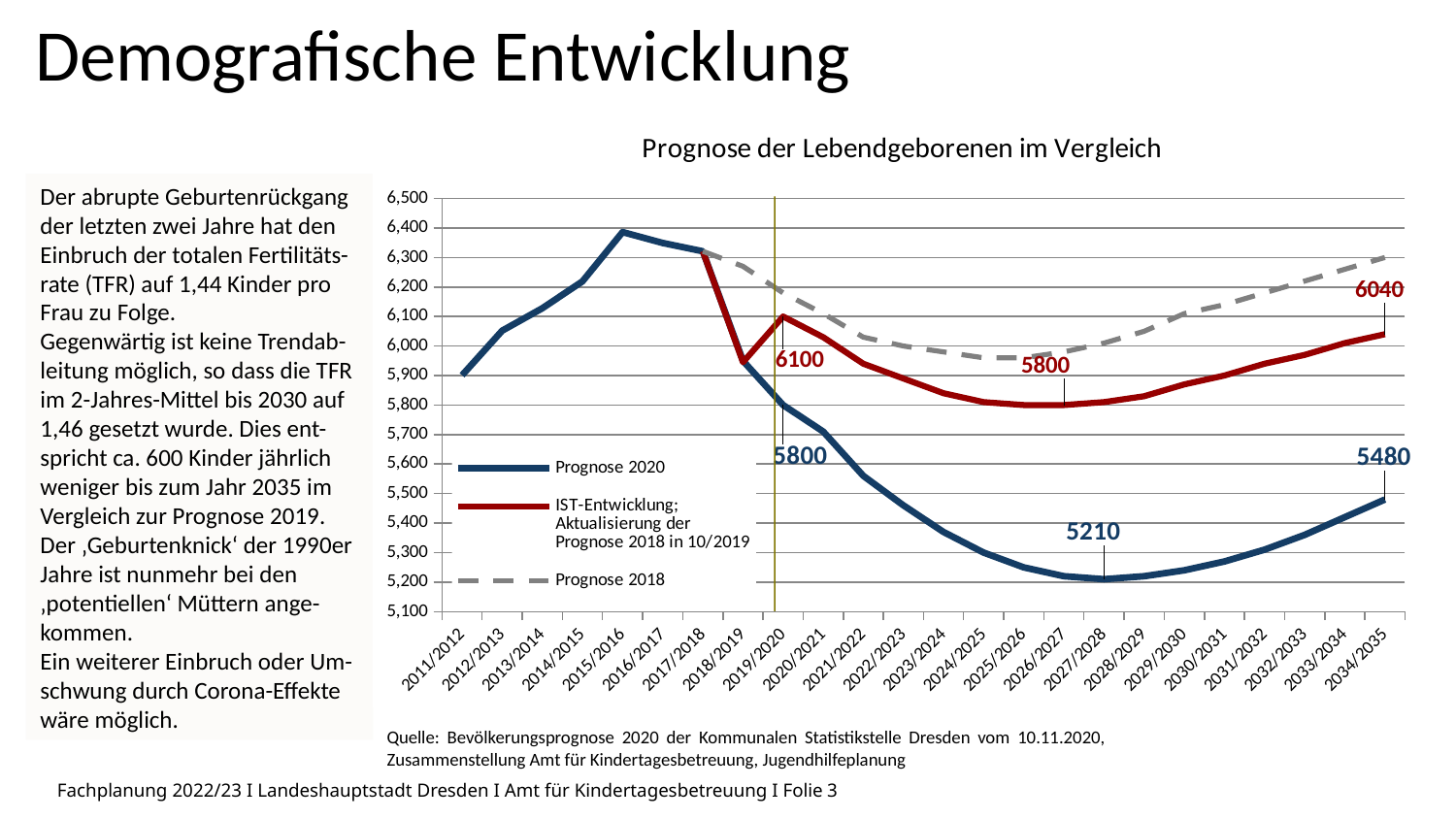
What is the difference between the IST-Entwicklung value and the Prognose 2020 value for 2034/2035? 560 Which series has the higher value for 2034/2035, Prognose 2020 or IST-Entwicklung? IST-Entwicklung What is the value of Prognose 2020 for 2027/2028? 5210 How many year categories are shown on the x axis? 24 What kind of chart is shown on the slide? line chart What is the value of the IST-Entwicklung series for 2019/2020? 6100 What is the value of the IST-Entwicklung series for 2034/2035? 6040 Is the value of Prognose 2018 for 2034/2035 greater or less than 6,200? greater How many series does the chart legend list? 3 What is the value of Prognose 2020 for 2034/2035? 5480 What is the value of Prognose 2020 for 2019/2020? 5800 What is the difference between the IST-Entwicklung value and the Prognose 2020 value for 2019/2020? 300